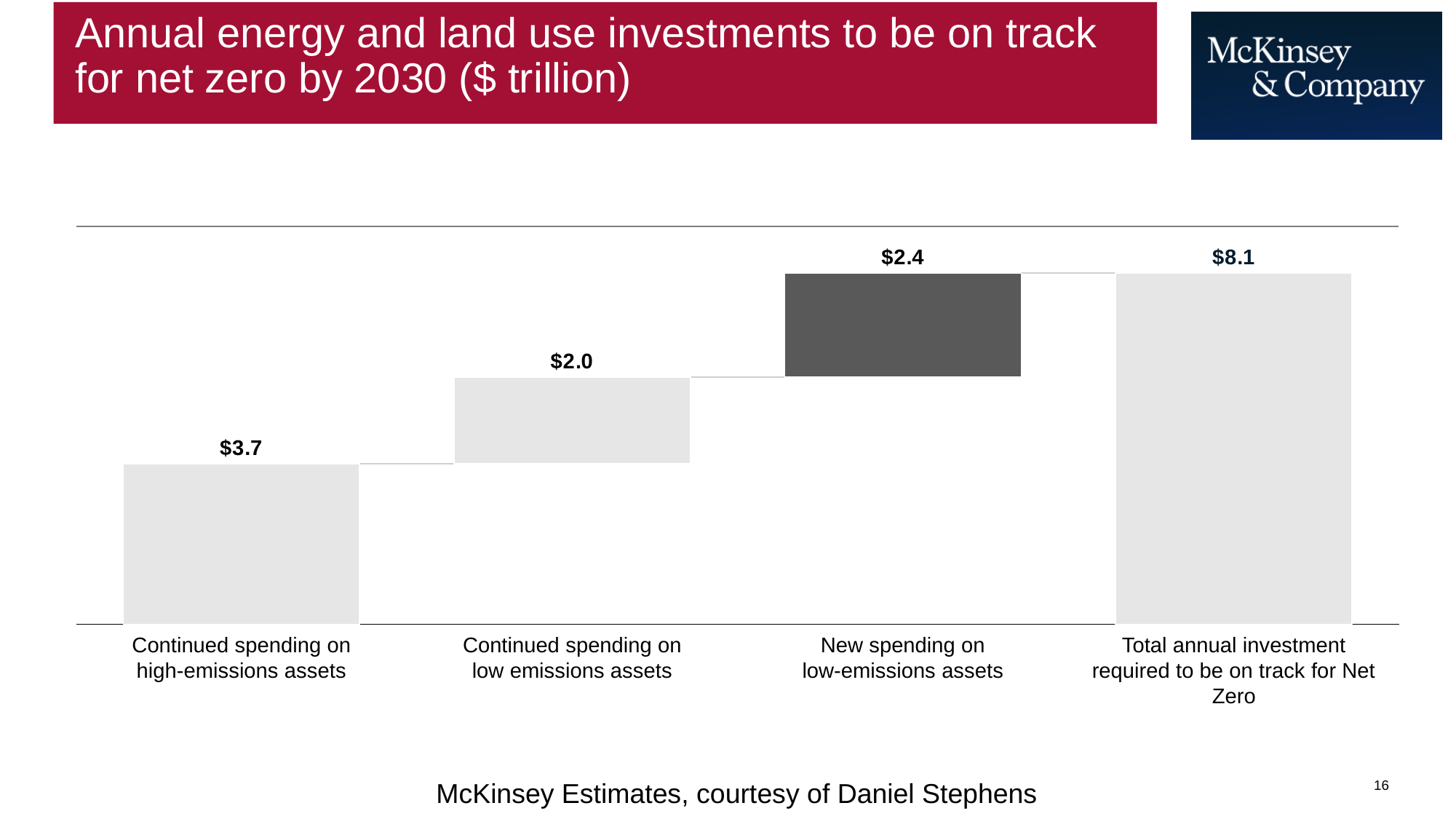
What is the value for Continued spending on low emissions assets? $2.0 What kind of chart is shown on the slide? Bar chart (waterfall) What is the value for Continued spending on high-emissions assets? $3.7 Which category has the highest value? Total annual investment required to be on track for Net Zero What is the value for New spending on low-emissions assets? $2.4 Which bar is shaded dark grey rather than light grey? New spending on low-emissions assets What is the title of the chart? Annual energy and land use investments to be on track for net zero by 2030 ($ trillion) Which category has the lowest value? Continued spending on low emissions assets How many categories are shown on the x axis? 4 Which is larger: New spending on low-emissions assets or Continued spending on low emissions assets? New spending on low-emissions assets What is the difference between Continued spending on high-emissions assets and New spending on low-emissions assets? $1.3 What is the value for Total annual investment required to be on track for Net Zero? $8.1